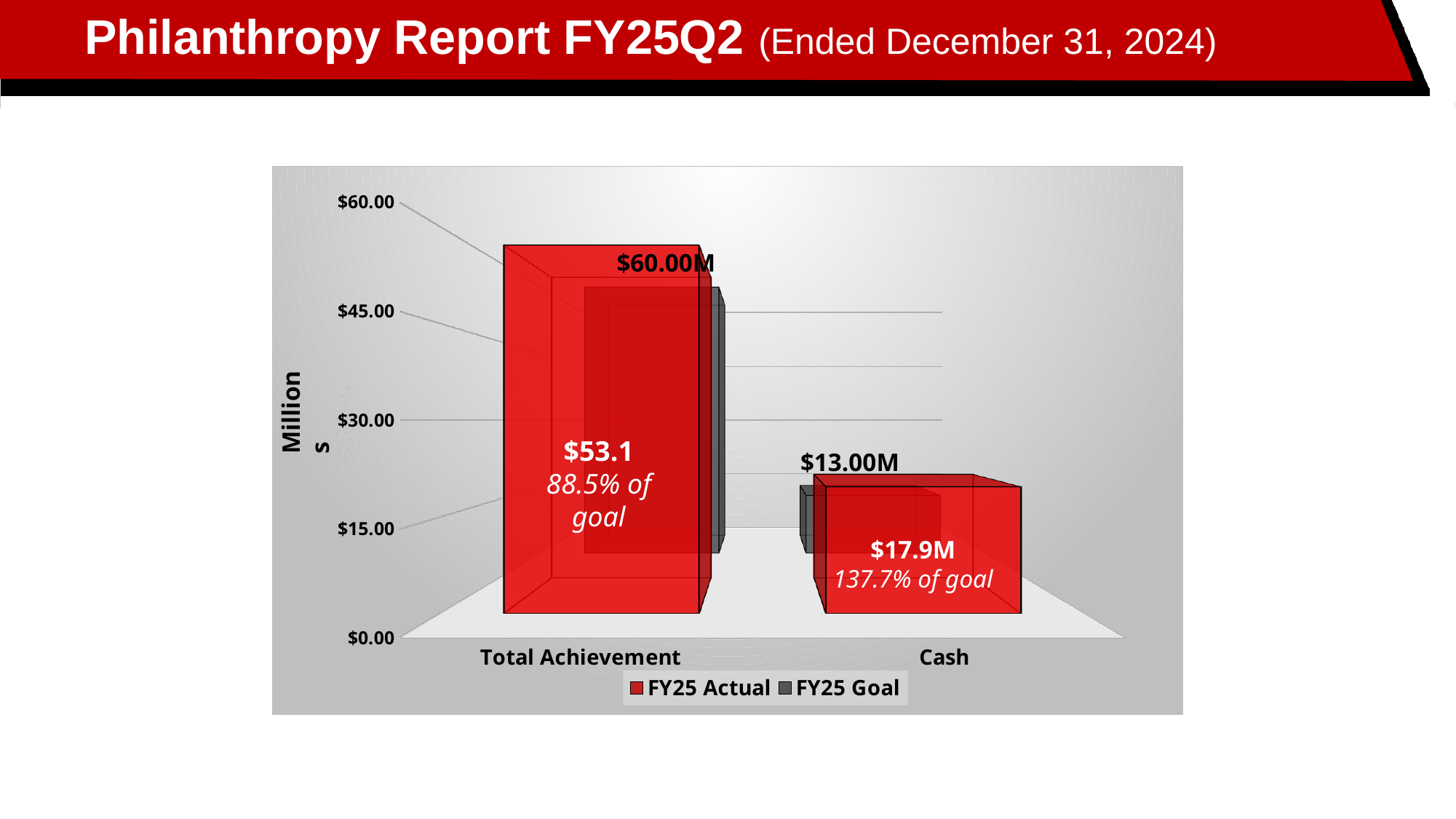
For Total Achievement, which is larger: the FY25 Actual or the FY25 Goal? FY25 Goal How many series does the legend list? 2 For Cash, which is larger: the FY25 Actual or the FY25 Goal? FY25 Actual What percentage of goal has been achieved for Cash? 137.7% of goal What is the FY25 Goal value for Cash? $13.00M By how much does the FY25 Actual for Cash exceed the FY25 Goal for Cash? $4.9M How many categories are shown on the x axis? 2 What is the FY25 Actual value for Cash? $17.9M What kind of chart is shown on the slide? Bar chart What percentage of goal has been achieved for Total Achievement? 88.5% of goal What is the FY25 Actual value for Total Achievement? $53.1 What is the FY25 Goal value for Total Achievement? $60.00M